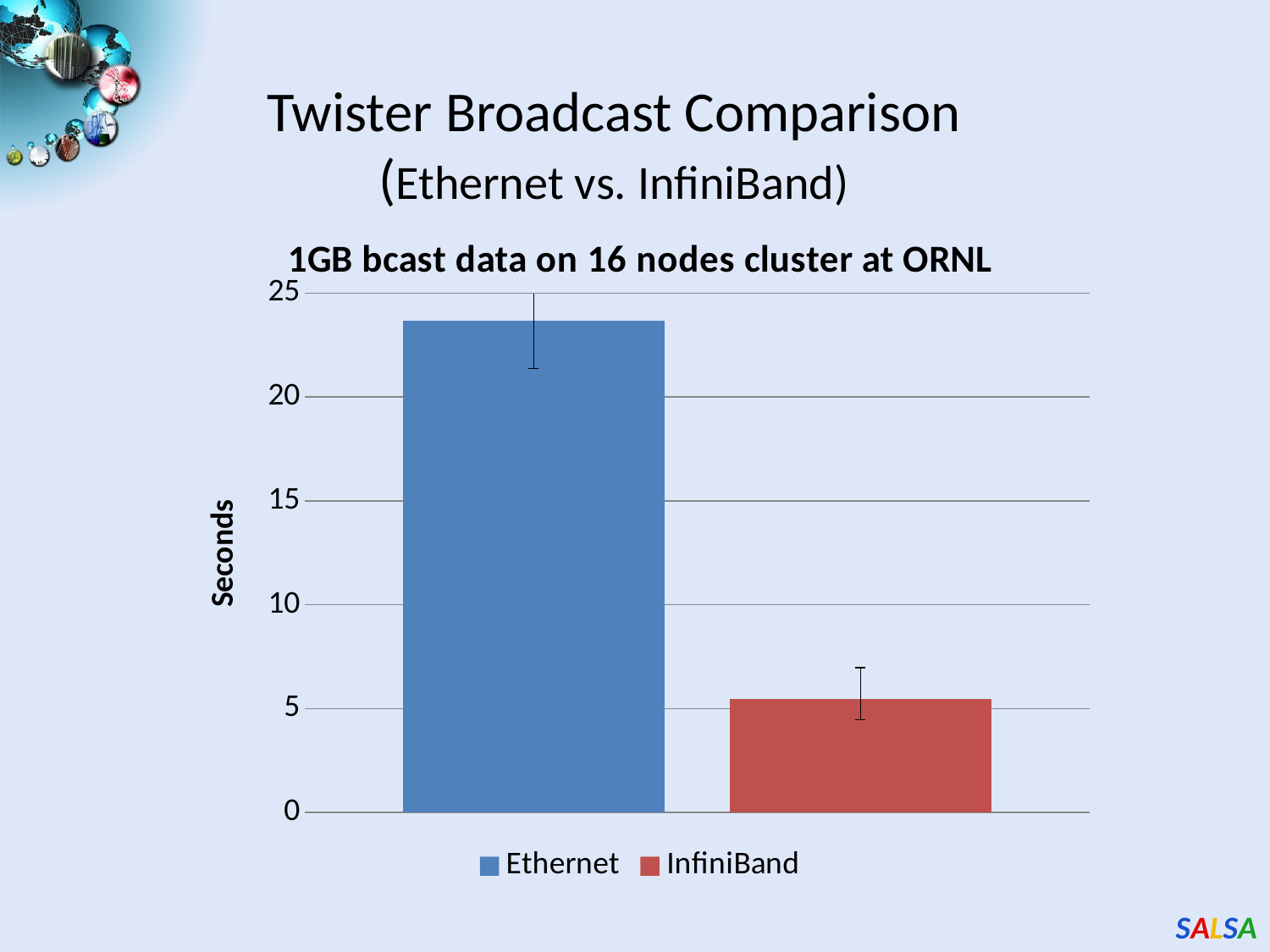
Which series has the lowest value? InfiniBand Is the value for Ethernet greater or less than 20? greater Which series has the highest value, Ethernet or InfiniBand? Ethernet How many series does the legend list? 2 How many bars are plotted in the chart? 2 Is the value for Ethernet greater or less than 25? less What kind of chart is shown on the slide? bar chart What is the label on the vertical axis of the chart? Seconds What is the title of the chart? 1GB bcast data on 16 nodes cluster at ORNL Which is larger, the value for Ethernet or the value for InfiniBand? Ethernet Is the value for InfiniBand greater or less than 10? less